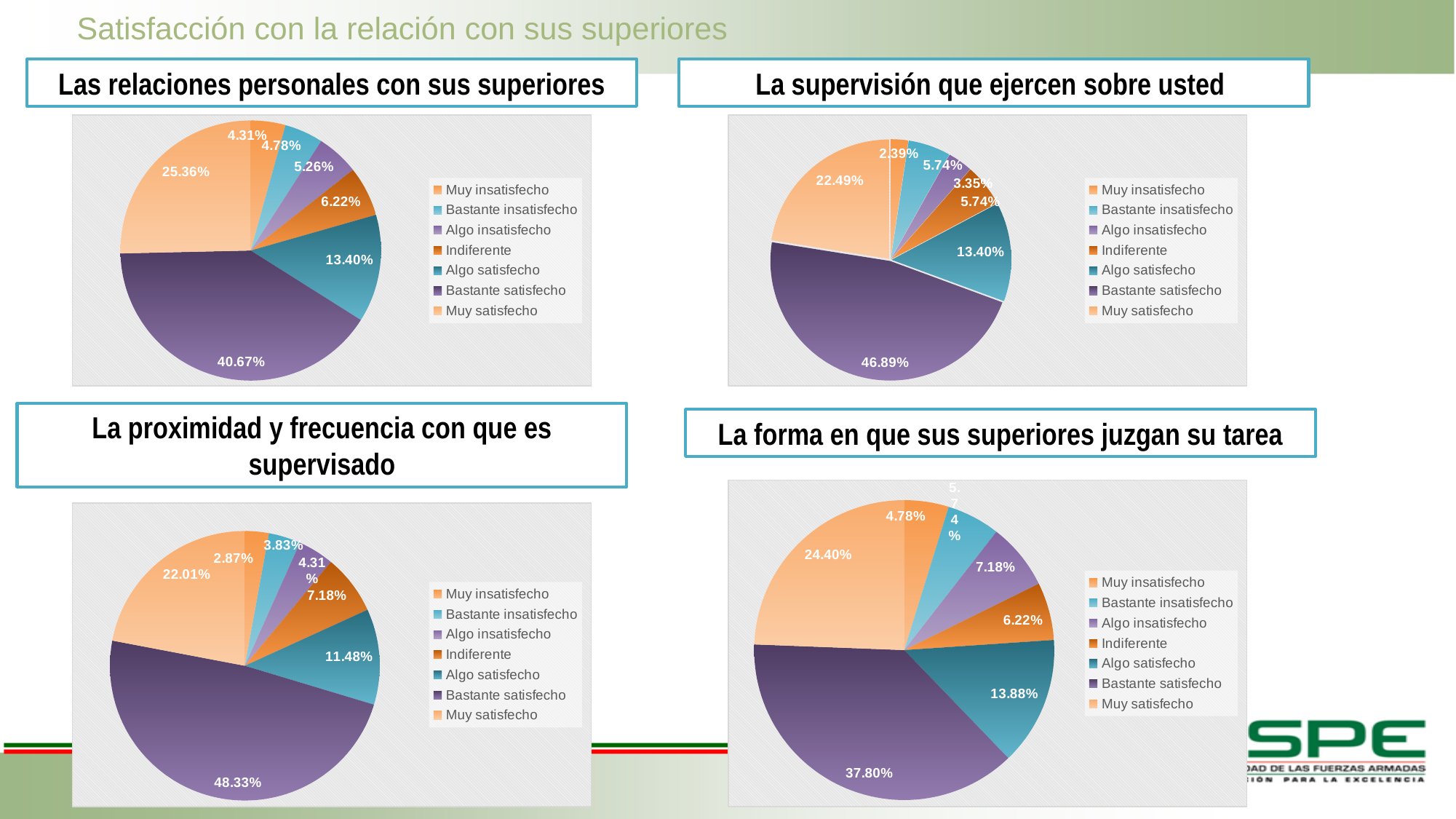
In the chart 'La forma en que sus superiores juzgan su tarea', what percentage is labelled for Algo satisfecho? 13.88% In the chart 'La supervisión que ejercen sobre usted', what percentage is labelled for Muy satisfecho? 22.49% How many categories does the legend list in the chart 'La supervisión que ejercen sobre usted'? 7 In the chart 'Las relaciones personales con sus superiores', which is larger: the Muy satisfecho slice or the Algo satisfecho slice? Muy satisfecho In the chart 'La proximidad y frecuencia con que es supervisado', what percentage is labelled for Indiferente? 7.18% In the chart 'Las relaciones personales con sus superiores', what percentage is labelled for Bastante satisfecho? 40.67% In the chart 'Las relaciones personales con sus superiores', what percentage is labelled for Algo satisfecho? 13.40% In the chart 'La supervisión que ejercen sobre usted', which category has the smallest slice? Muy insatisfecho What type of chart is used for 'La proximidad y frecuencia con que es supervisado'? Pie chart In the chart 'La forma en que sus superiores juzgan su tarea', what is the difference between the Bastante satisfecho and Muy satisfecho slices? 13.40% In the chart 'La proximidad y frecuencia con que es supervisado', which category has the largest slice? Bastante satisfecho How many charts are shown on the slide? 4